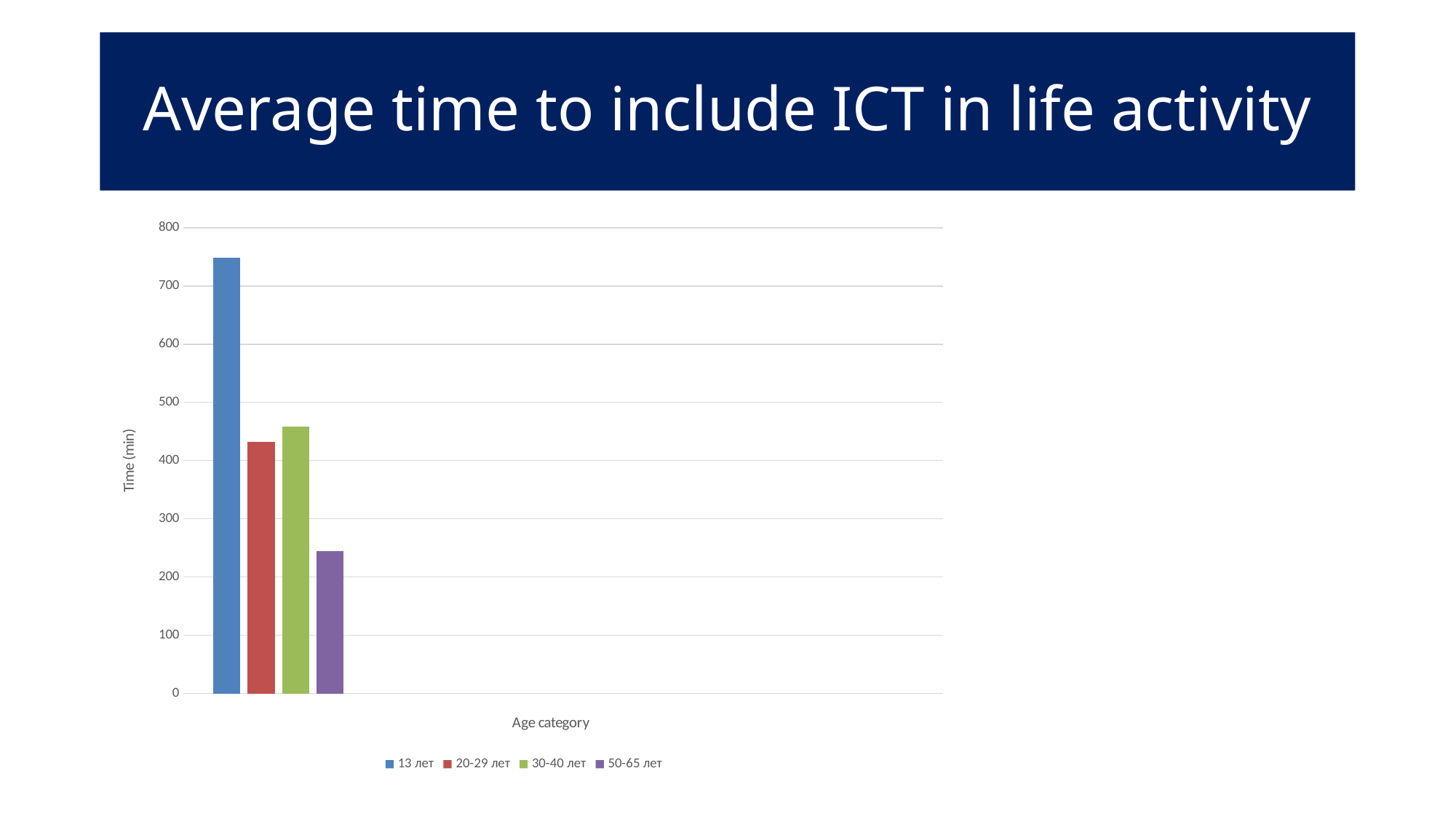
Which age group has the lowest average time? 50-65 лет Is the value for 20-29 лет greater or less than 400? greater Is the value for 30-40 лет greater or less than 500? less Is the value for 50-65 лет greater or less than 200? greater What is the title of the chart? Average time to include ICT in life activity Which is larger, the value for 13 лет or the value for 50-65 лет? 13 лет What kind of chart is shown on the slide? bar chart What is the label of the vertical axis? Time (min) How many series does the legend list? 4 Which age group has the highest average time? 13 лет